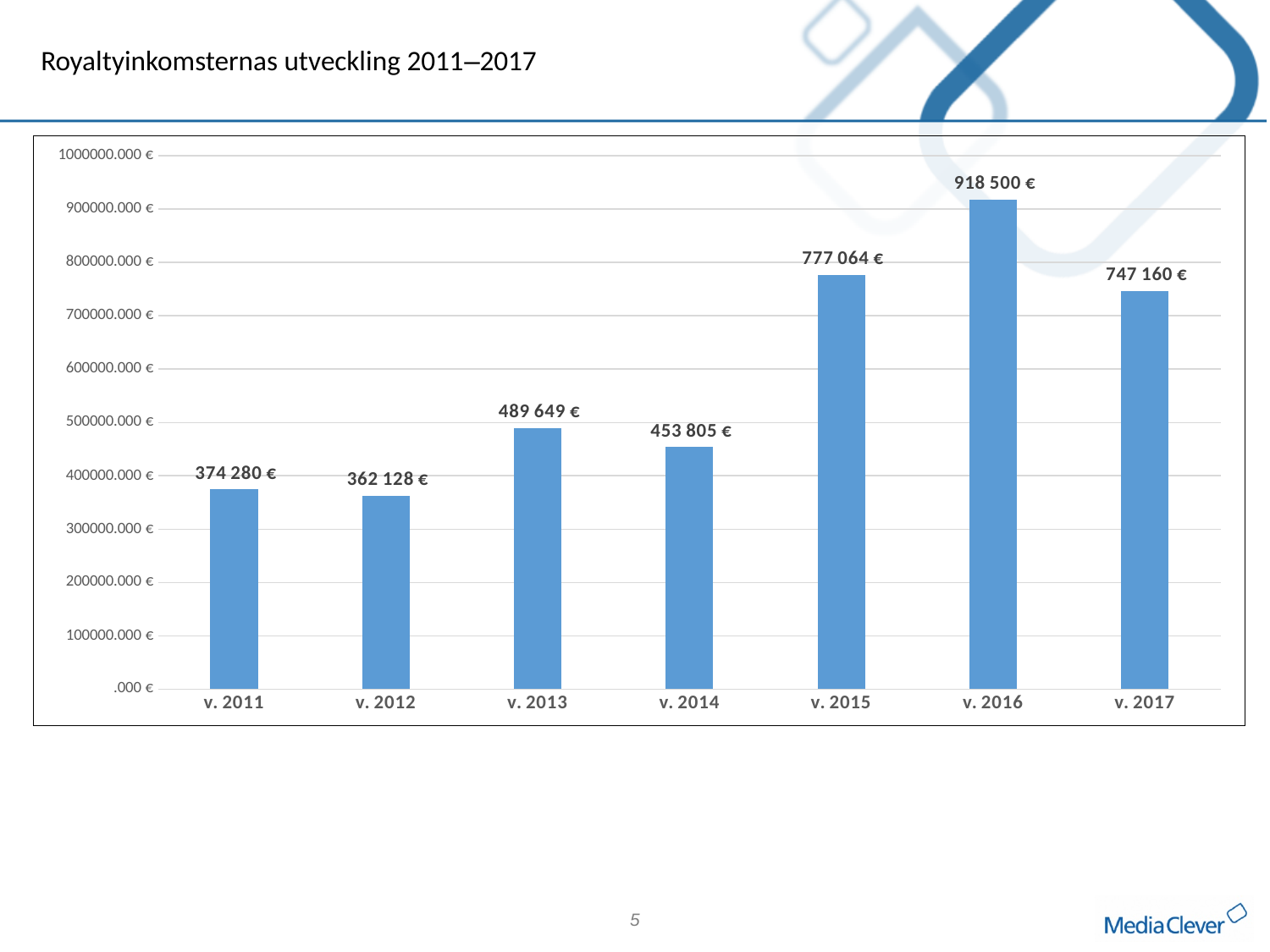
Which year has the highest value? v. 2016 What is the value for v. 2013? 489 649 € What type of chart is shown on the slide? bar chart What is the difference between the values for v. 2011 and v. 2012? 12 152 € Between v. 2014 and v. 2016, do the values rise or fall? rise Which is larger, the value for v. 2013 or the value for v. 2014? v. 2013 What is the difference between the values for v. 2016 and v. 2015? 141 436 € Is the value for v. 2015 greater or less than 700000.000 €? greater How many years are shown on the x axis? 7 What is the value for v. 2016? 918 500 € What is the value for v. 2017? 747 160 € Which year has the lowest value? v. 2012